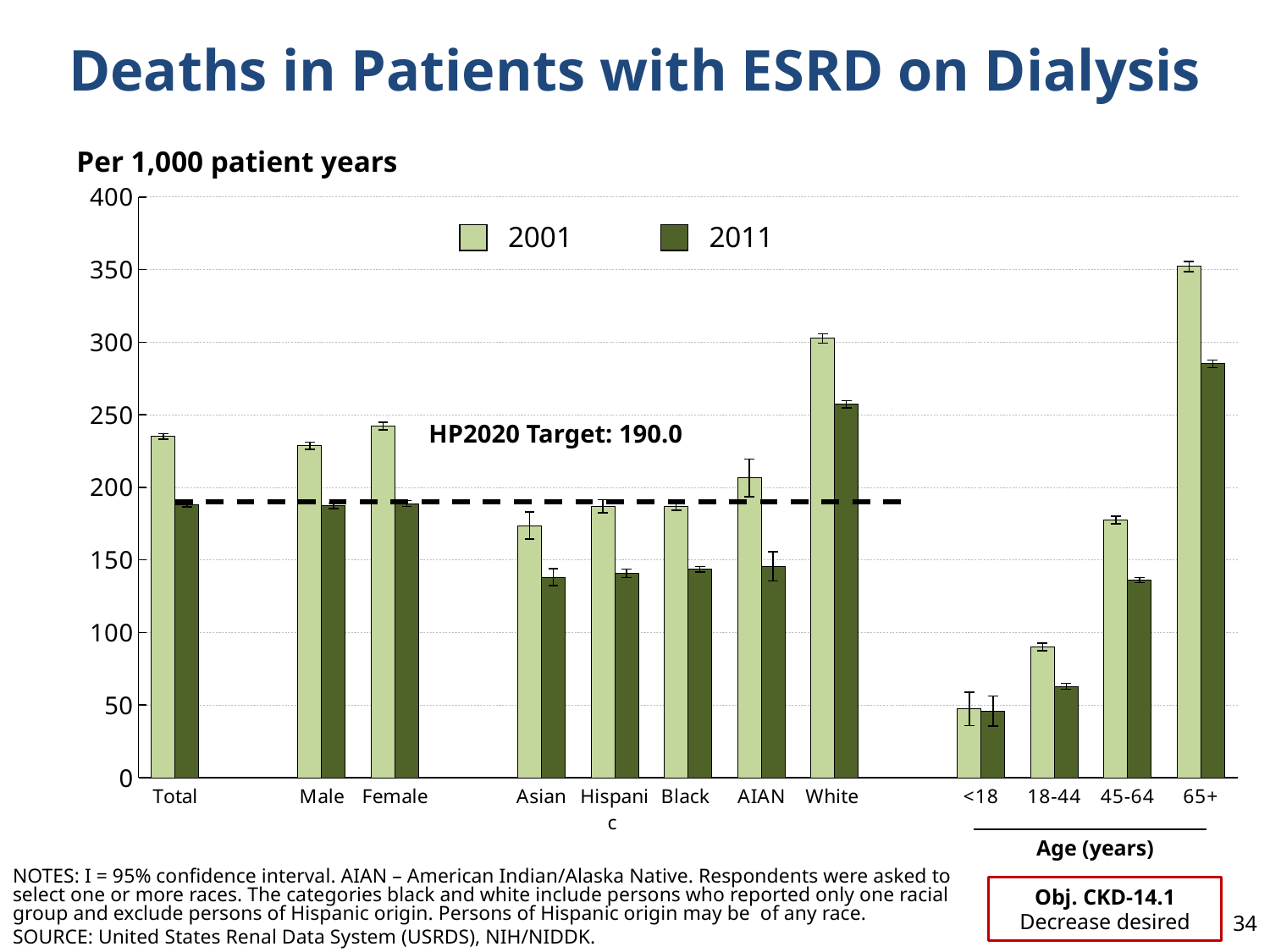
What is the HP2020 Target value shown on the chart? 190.0 Across the age groups from <18 to 65+, do the 2011 values rise or fall? rise How many categories are shown along the x axis? 12 Which category has the highest 2001 value? 65+ Which is larger, the 2001 value for White or the 2001 value for Total? White Which years are listed in the legend? 2001 and 2011 What kind of chart is shown on the slide? bar chart Is the 2011 value for 65+ greater or less than 250? greater Is the 2001 value for Total greater or less than 200? greater How many series does the legend list? 2 Which category has the lowest 2011 value? <18 Is the 2001 value for 18-44 greater or less than 100? less